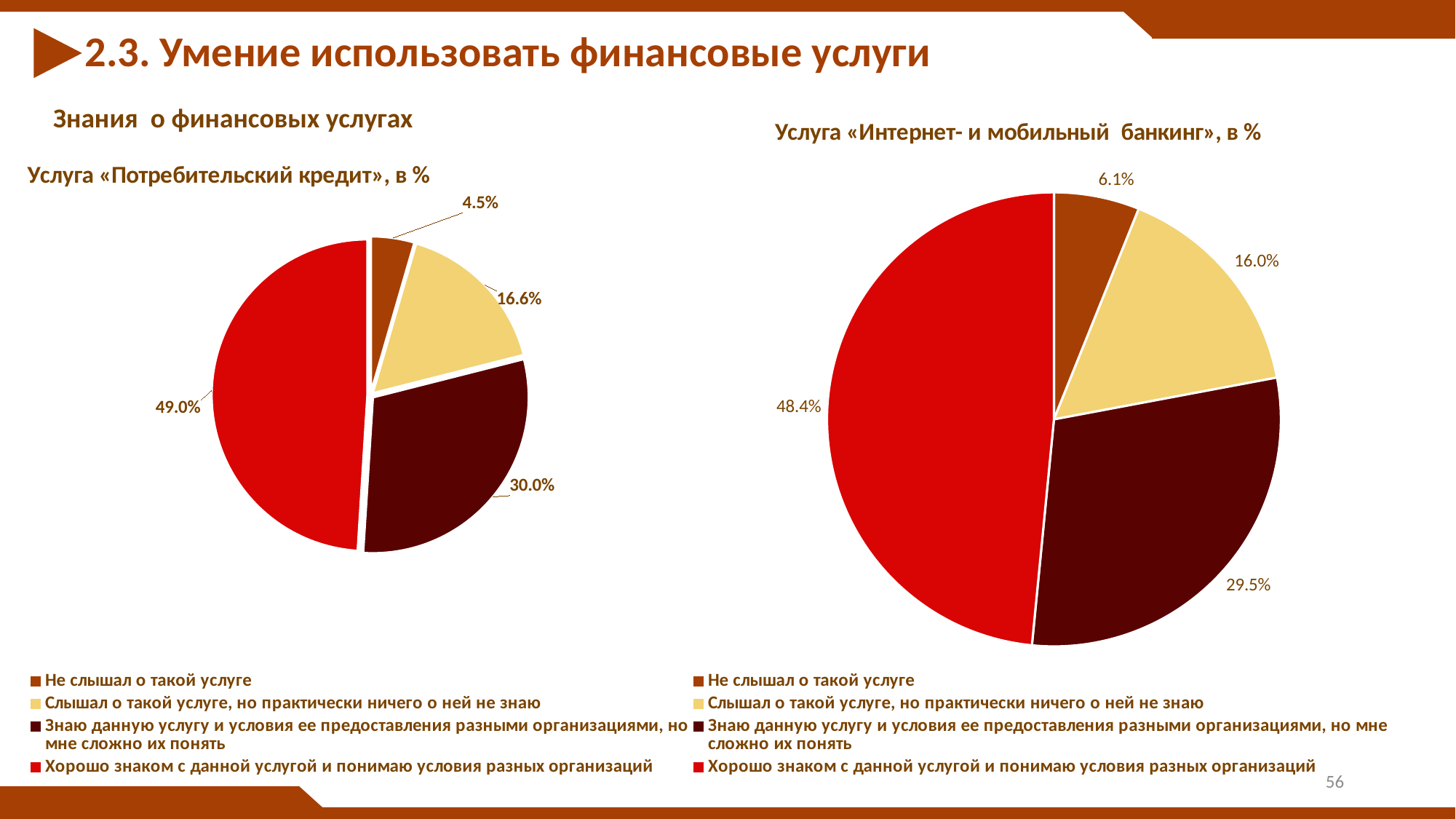
In the chart «Услуга «Потребительский кредит», в %», what is the difference between the values for «Хорошо знаком с данной услугой и понимаю условия разных организаций» and «Знаю данную услугу и условия ее предоставления разными организациями, но мне сложно их понять»? 19.0% In the chart «Услуга «Потребительский кредит», в %», what is the value for «Не слышал о такой услуге»? 4.5% How many slices does the chart «Услуга «Интернет- и мобильный банкинг», в %» have? 4 In the chart «Услуга «Интернет- и мобильный банкинг», в %», which category has the largest share? Хорошо знаком с данной услугой и понимаю условия разных организаций What type of chart is used on the slide for «Услуга «Потребительский кредит», в %»? Pie chart In the chart «Услуга «Потребительский кредит», в %», which category has the smallest share? Не слышал о такой услуге How many entries does the legend of the chart «Услуга «Потребительский кредит», в %» list? 4 In the chart «Услуга «Интернет- и мобильный банкинг», в %», what is the value for «Слышал о такой услуге, но практически ничего о ней не знаю»? 16.0% Which is larger: the value for «Не слышал о такой услуге» in the chart «Услуга «Потребительский кредит», в %» or in the chart «Услуга «Интернет- и мобильный банкинг», в %»? Услуга «Интернет- и мобильный банкинг», в % (6.1%) In the chart «Услуга «Потребительский кредит», в %», what is the value for «Хорошо знаком с данной услугой и понимаю условия разных организаций»? 49.0% In the chart «Услуга «Интернет- и мобильный банкинг», в %», what is the value for «Знаю данную услугу и условия ее предоставления разными организациями, но мне сложно их понять»? 29.5% In the chart «Услуга «Интернет- и мобильный банкинг», в %», what colour is the slice for «Не слышал о такой услуге»? Brown